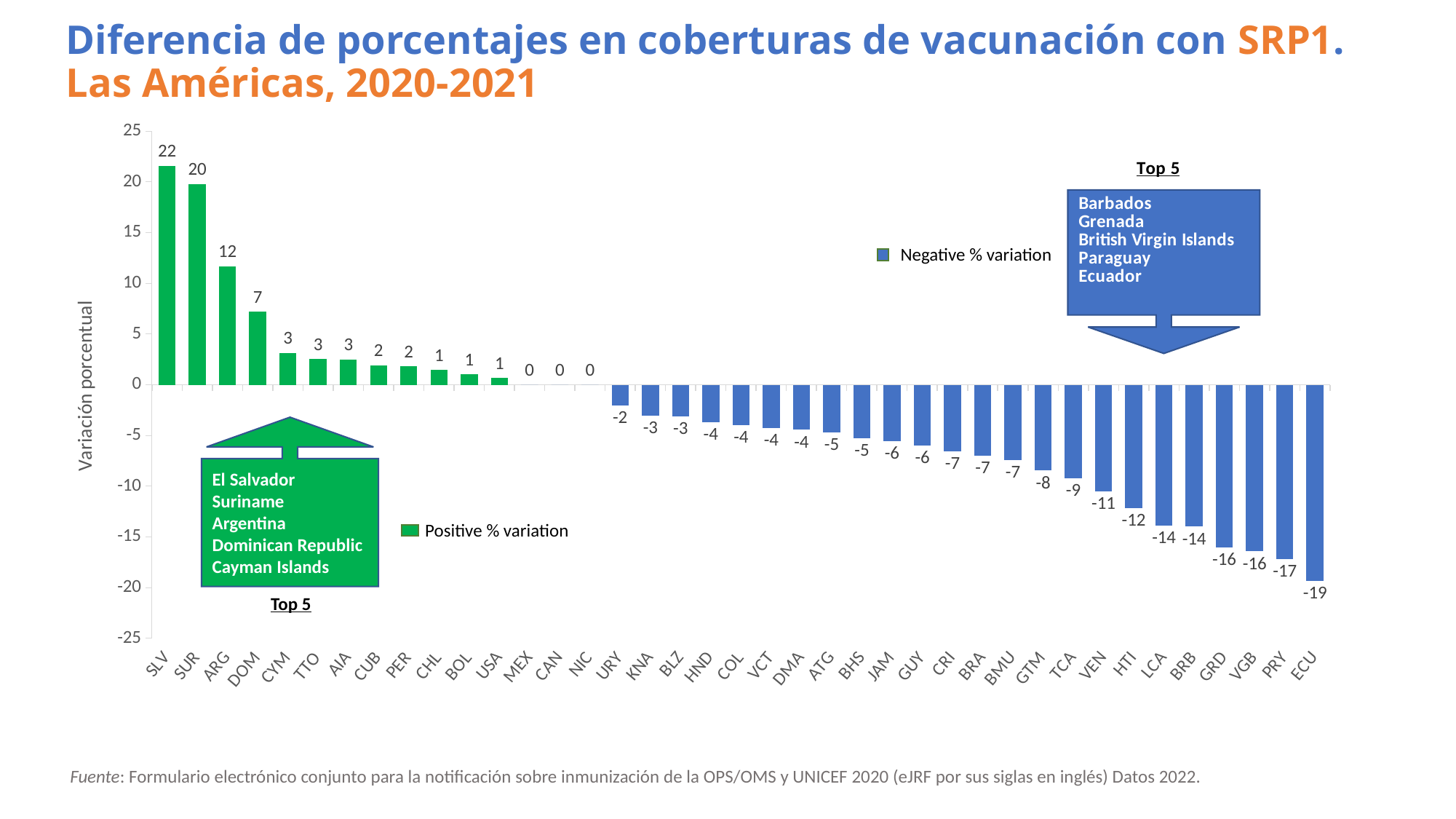
Which country has the lowest value? ECU What is the value for ARG? 12 What is the value for SLV? 22 Which country has the highest value? SLV Which has a larger value, DOM or ARG? ARG What is the difference between the values for SLV and SUR? 2 What kind of chart is this? Bar chart Do the values rise or fall from left to right along the x axis? Fall What is the value for ECU? -19 How many countries are shown on the x axis? 39 How many series does the legend list? 2 What is the value for VEN? -11